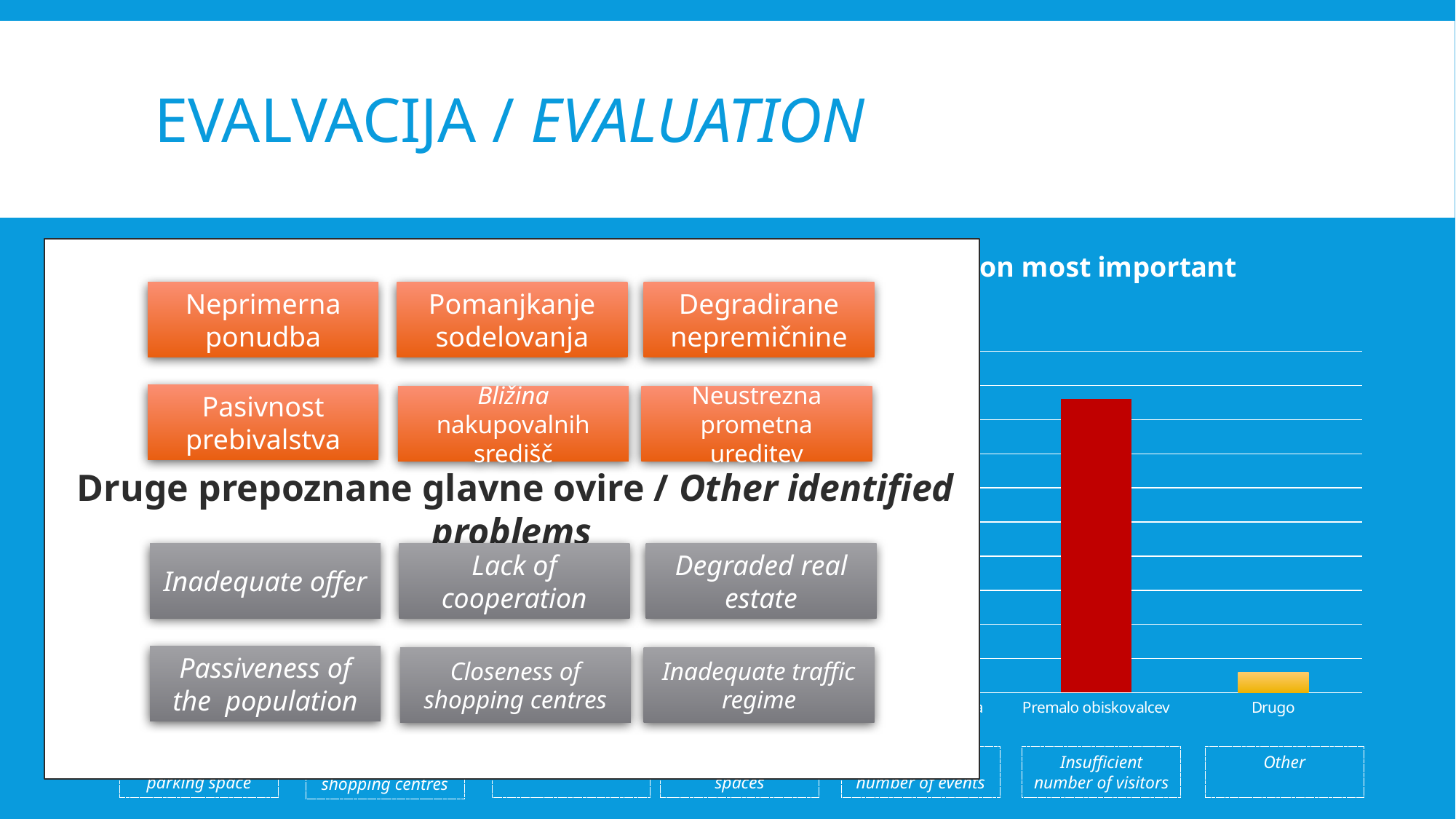
What kind of chart is shown on the right side of the slide? bar chart What is the English translation label shown under the Premalo obiskovalcev bar? Insufficient number of visitors Which is larger, the value for Premalo obiskovalcev or the value for Drugo? Premalo obiskovalcev Which of the two visible categories, Premalo obiskovalcev or Drugo, has the lower value? Drugo What colour is the bar for Premalo obiskovalcev? red What colour is the bar for Drugo? yellow